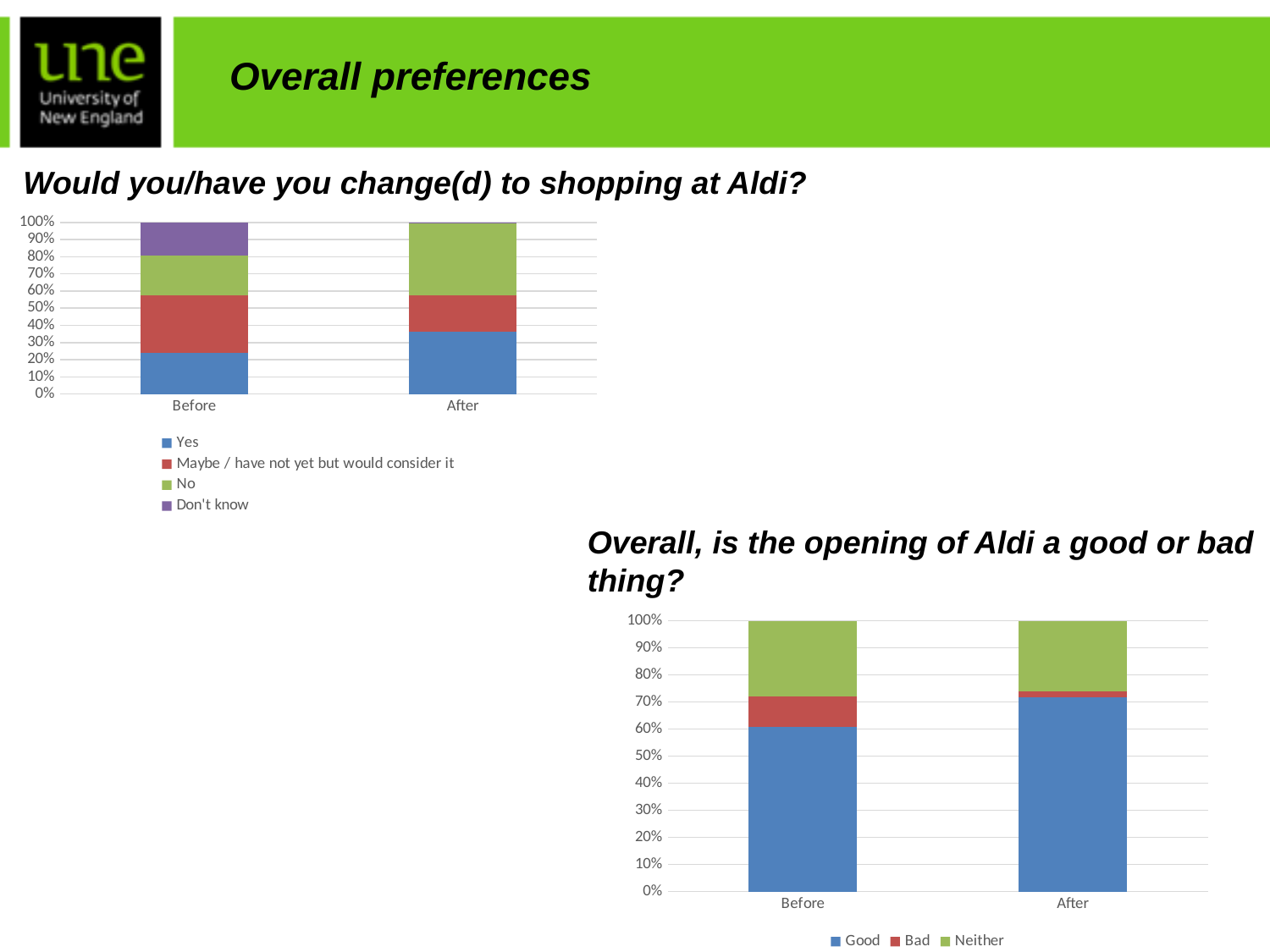
In the chart 'Would you/have you change(d) to shopping at Aldi?', how many categories are shown on the x axis? 2 In the chart 'Overall, is the opening of Aldi a good or bad thing?', which category has the larger 'Good' share, Before or After? After In the chart 'Would you/have you change(d) to shopping at Aldi?', how many series does the legend list? 4 In the chart 'Overall, is the opening of Aldi a good or bad thing?', is the 'Good' value for Before greater or less than 50%? greater In the chart 'Overall, is the opening of Aldi a good or bad thing?', how many series does the legend list? 3 In the chart 'Would you/have you change(d) to shopping at Aldi?', is the 'Yes' value for After greater or less than 30%? greater In the chart 'Overall, is the opening of Aldi a good or bad thing?', is the 'Good' value for Before greater or less than 70%? less In the chart 'Would you/have you change(d) to shopping at Aldi?', which category has the larger 'Yes' share, Before or After? After In the chart 'Overall, is the opening of Aldi a good or bad thing?', does the 'Good' share rise or fall from Before to After? Rise In the chart 'Would you/have you change(d) to shopping at Aldi?', which legend entry is shown in purple? Don't know What kind of chart is 'Overall, is the opening of Aldi a good or bad thing?' Stacked bar chart